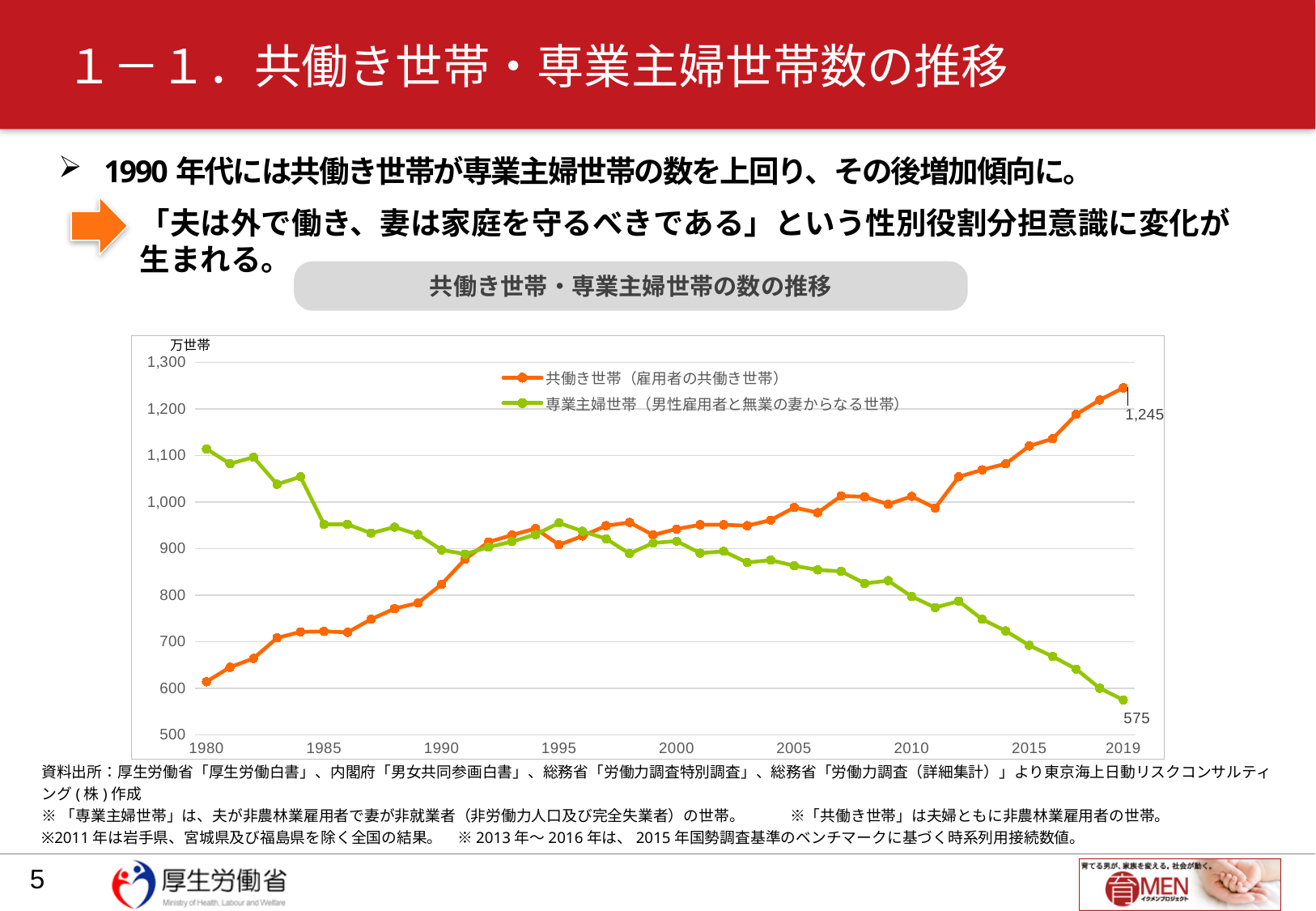
What kind of chart is shown on the slide? line chart What is the value for 専業主婦世帯 in 2019? 575 What unit is shown on the vertical axis of the chart? 万世帯 Is the value for 共働き世帯 in 1980 greater or less than 700? less In which year does the 共働き世帯 series reach its highest value? 2019 In 2019, which series has the larger value, 共働き世帯 or 専業主婦世帯? 共働き世帯 What is the value for 共働き世帯 in 2019? 1,245 In 1980, which series has the larger value, 共働き世帯 or 専業主婦世帯? 専業主婦世帯 Does the 専業主婦世帯 series rise or fall from 1980 to 2019? fall How many series does the legend list? 2 What is the difference between the 共働き世帯 and 専業主婦世帯 values in 2019? 670 Is the value for 専業主婦世帯 in 1980 greater or less than 1,000? greater